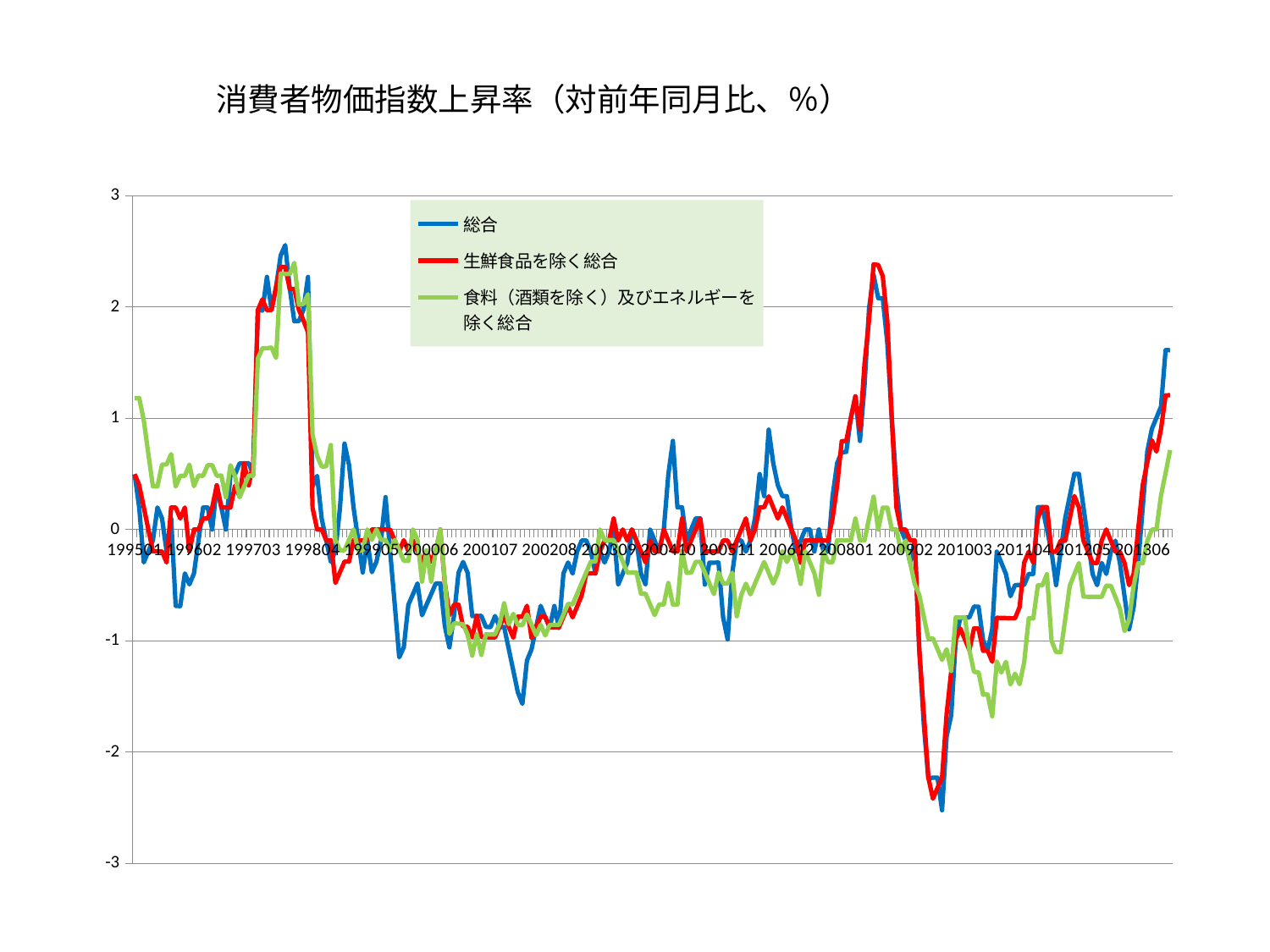
Is the lowest value of the 食料（酒類を除く）及びエネルギーを除く総合 series around 201003 greater or less than -1? less Does the 総合 series rise or fall between 199804 and 199905? fall Is the value of the 食料（酒類を除く）及びエネルギーを除く総合 series at 199501 greater or less than 1? greater How many series does the legend list? 3 What is the title of the chart? 消費者物価指数上昇率（対前年同月比、%） Which series is drawn in green according to the legend? 食料（酒類を除く）及びエネルギーを除く総合 Is the peak value of the 総合 series around 199703 greater or less than 2? greater How many date labels are shown on the x axis? 18 What kind of chart is shown on the slide? line chart